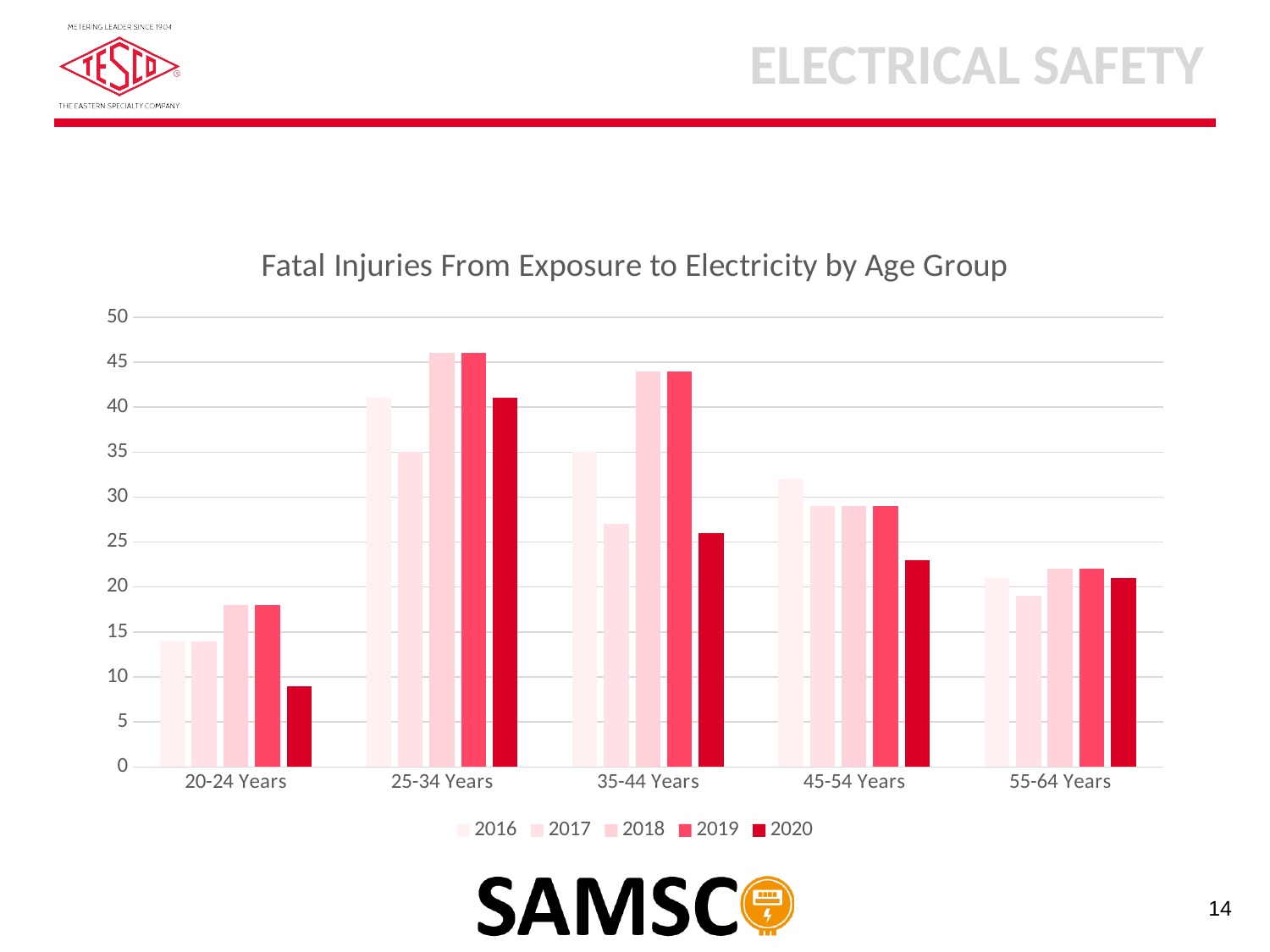
Is the value for 2020 in the 35-44 Years group greater or less than 30? less Which years are listed in the legend? 2016, 2017, 2018, 2019, 2020 How many age group categories are shown on the x axis? 5 Is the value for 2016 in the 45-54 Years group greater or less than 30? greater Which age group has the lowest 2020 value? 20-24 Years What kind of chart is shown on the slide? Bar chart How many series does the legend list? 5 Which is larger in the 35-44 Years group, the 2017 value or the 2019 value? 2019 Is the value for 2018 in the 25-34 Years group greater or less than 45? greater What is the title of the chart? Fatal Injuries From Exposure to Electricity by Age Group Which age group has the highest 2018 value? 25-34 Years